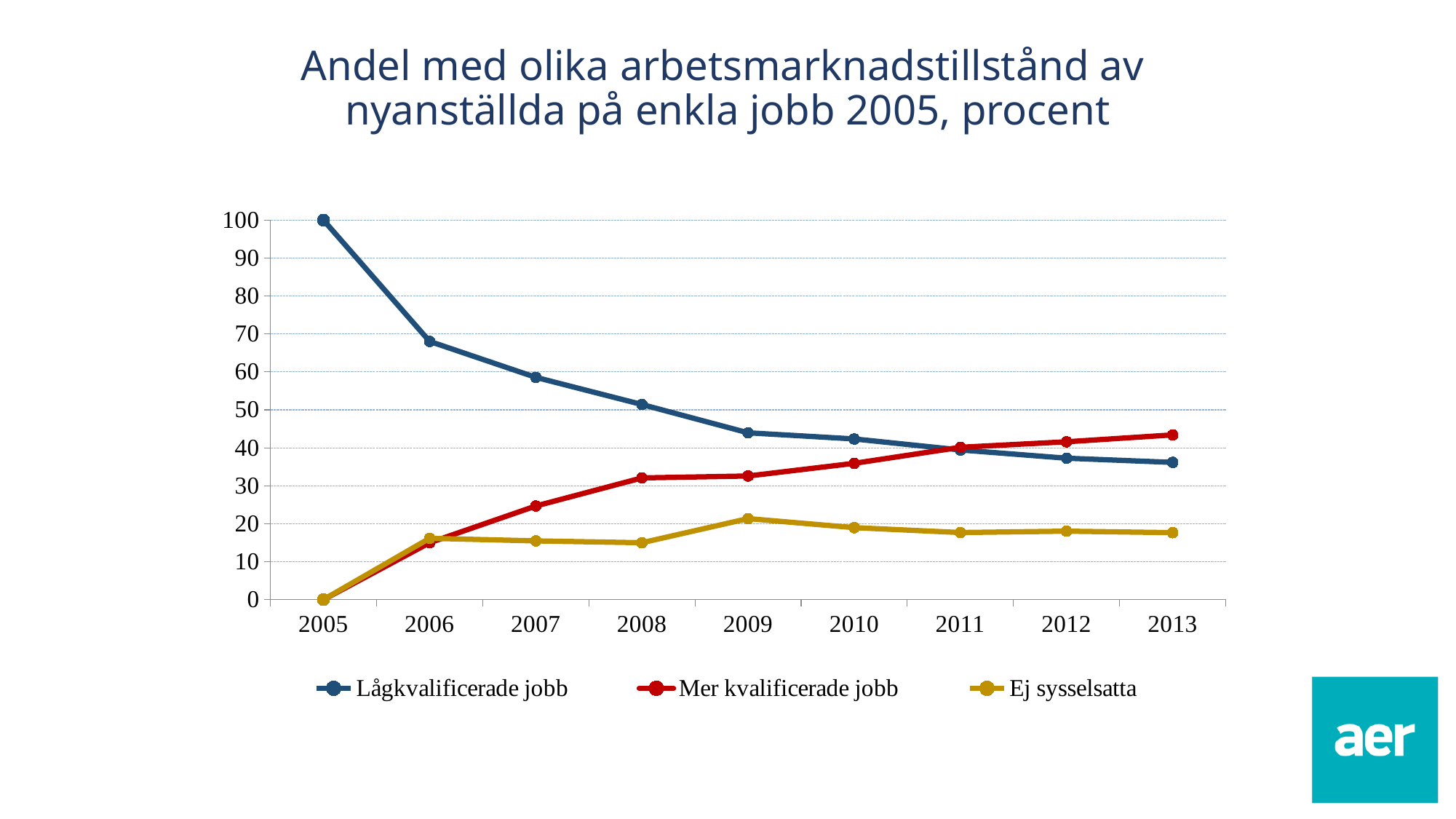
In 2013, which is larger: Mer kvalificerade jobb or Lågkvalificerade jobb? Mer kvalificerade jobb How many years are shown on the x axis? 9 Is the value for Lågkvalificerade jobb in 2013 greater or less than 40? less What is the value for Mer kvalificerade jobb in 2005? 0 How many series does the legend list? 3 Which series has the highest value in 2005? Lågkvalificerade jobb What kind of chart is shown on the slide? line chart Is the value for Lågkvalificerade jobb in 2006 greater or less than 60? greater What is the value for Lågkvalificerade jobb in 2005? 100 What is the title of the chart? Andel med olika arbetsmarknadstillstånd av nyanställda på enkla jobb 2005, procent Does the value for Lågkvalificerade jobb rise or fall from 2005 to 2013? fall Which series has the lowest value in 2013? Ej sysselsatta